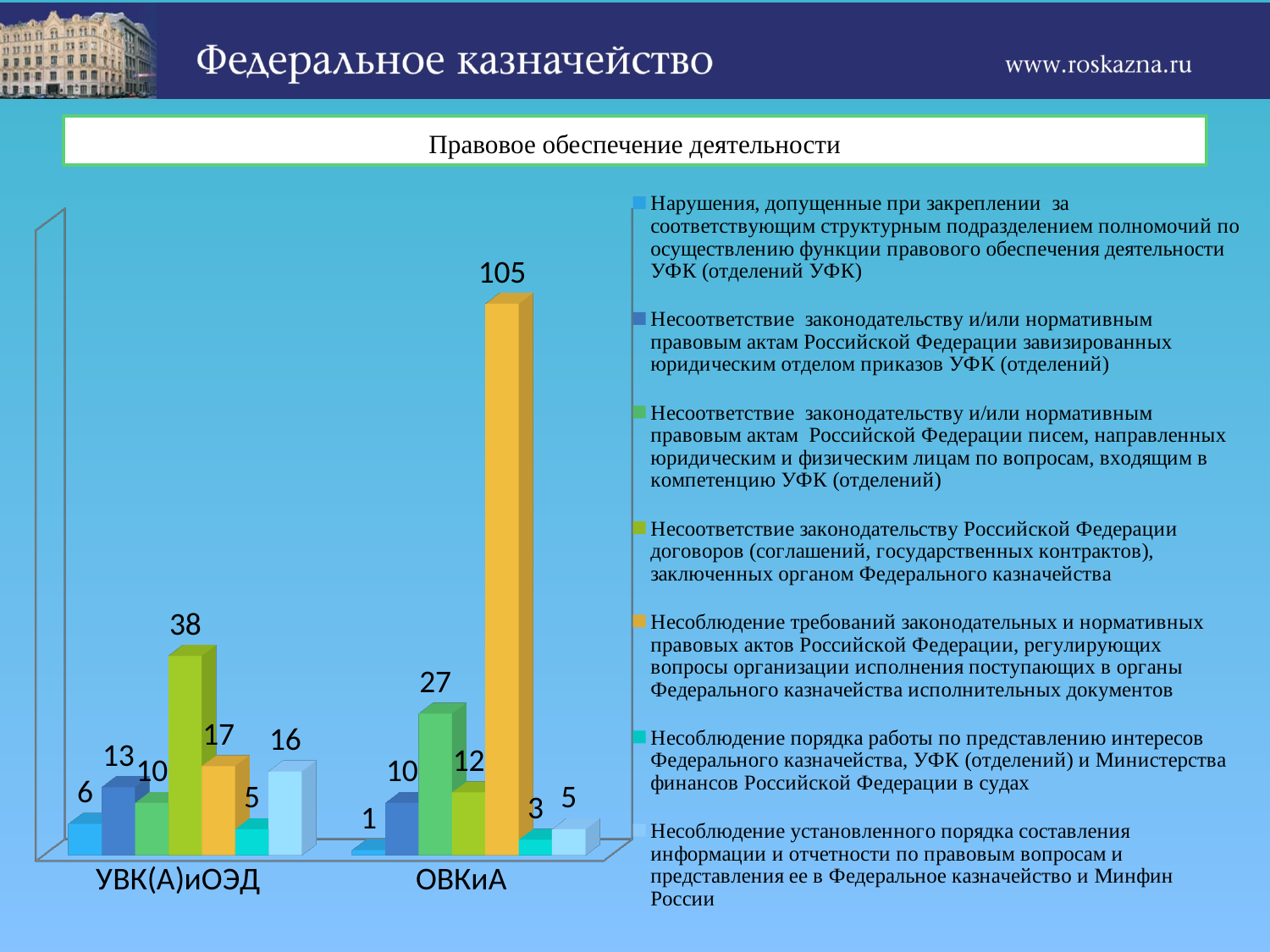
How many series does the chart legend list? 7 What is the highest value shown in the chart, and for which category? 105, ОВКиА What is the title shown in the box above the chart? Правовое обеспечение деятельности What is the difference between the values 17 and 5 for УВК(А)иОЭД? 12 What is the difference between the value 105 for ОВКиА and the value 38 for УВК(А)иОЭД? 67 What type of chart is shown on the slide? bar chart What is the value of the tallest bar for УВК(А)иОЭД? 38 How many categories are shown on the x axis of the chart? 2 What is the value for ОВКиА for the series 'Несоответствие законодательству и/или нормативным правовым актам Российской Федерации писем, направленных юридическим и физическим лицам...'? 27 Which category has the larger value for the series 'Несоответствие законодательству Российской Федерации договоров (соглашений, государственных контрактов)...': УВК(А)иОЭД (38) or ОВКиА (12)? УВК(А)иОЭД What is the lowest value shown for ОВКиА? 1 What is the value for УВК(А)иОЭД for the series 'Несоблюдение установленного порядка составления информации и отчетности по правовым вопросам...'? 16